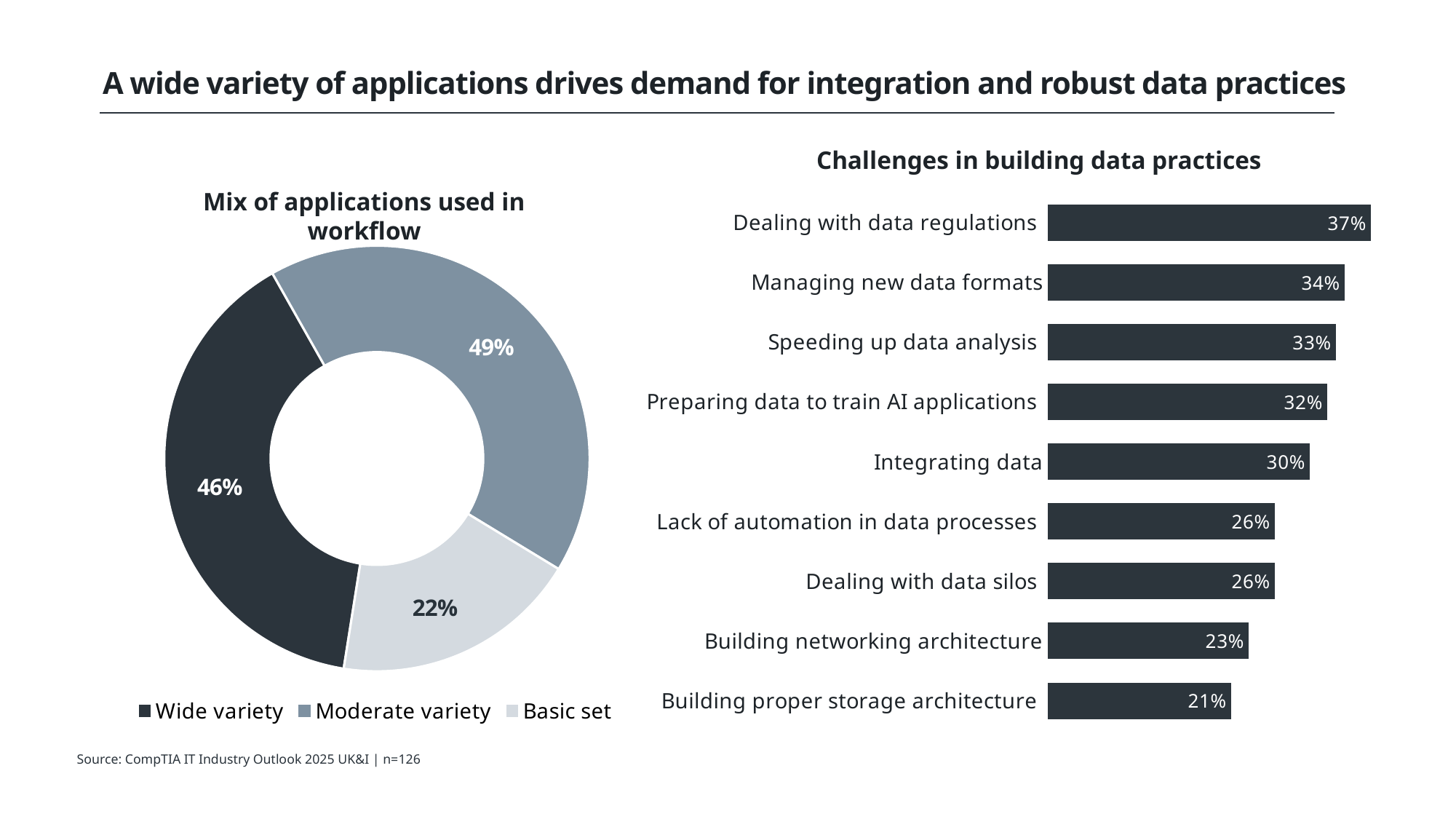
In the 'Challenges in building data practices' chart, what is the value for Dealing with data regulations? 37% What kind of chart is 'Mix of applications used in workflow'? Doughnut chart In the 'Mix of applications used in workflow' chart, what share is labelled for Moderate variety? 49% In the 'Challenges in building data practices' chart, which challenge has the lowest value? Building proper storage architecture In the 'Challenges in building data practices' chart, what is the value for Integrating data? 30% What kind of chart is 'Challenges in building data practices'? Bar chart In the 'Mix of applications used in workflow' chart, what share is labelled for Basic set? 22% In the 'Mix of applications used in workflow' chart, how many categories does the legend list? 3 In the 'Mix of applications used in workflow' chart, which category has the smallest share? Basic set In the 'Challenges in building data practices' chart, how many challenges are listed? 9 In the 'Challenges in building data practices' chart, which challenge has the highest value? Dealing with data regulations In the 'Challenges in building data practices' chart, what is the difference between Managing new data formats and Building networking architecture? 11%